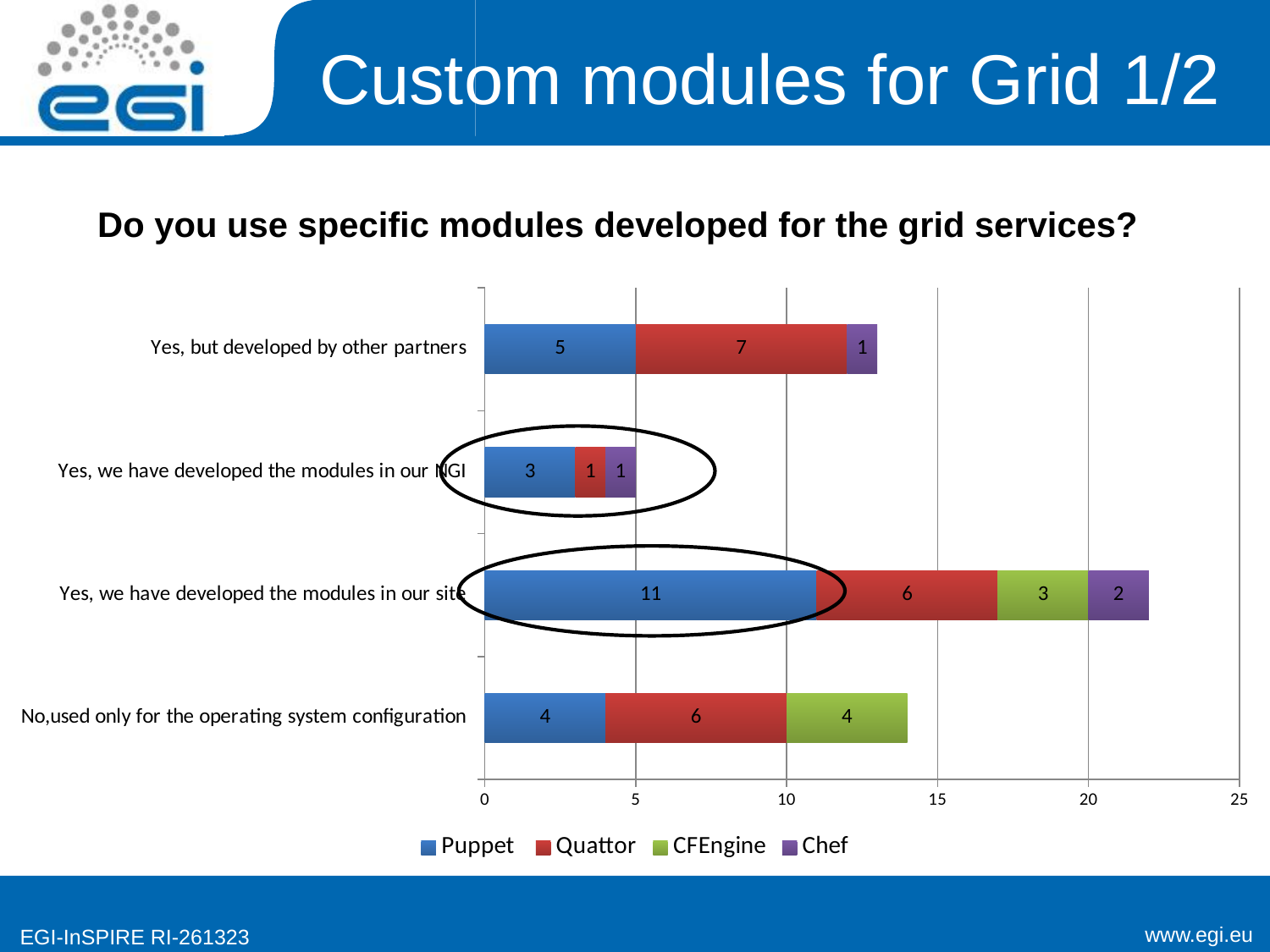
Which category has the highest Puppet value? Yes, we have developed the modules in our site Which series is shown in green in the legend? CFEngine What is the difference between the Puppet value for "Yes, we have developed the modules in our site" and the Puppet value for "Yes, but developed by other partners"? 6 What is the Puppet value for "Yes, we have developed the modules in our site"? 11 What is the Chef value for "Yes, we have developed the modules in our site"? 2 What is the total of the stacked bar for "Yes, we have developed the modules in our site"? 22 What is the Quattor value for "Yes, but developed by other partners"? 7 How many categories are shown on the chart? 4 What is the CFEngine value for "No,used only for the operating system configuration"? 4 How many series does the legend list? 4 What is the total of the stacked bar for "Yes, we have developed the modules in our NGI"? 5 What kind of chart is shown on the slide? Stacked bar chart